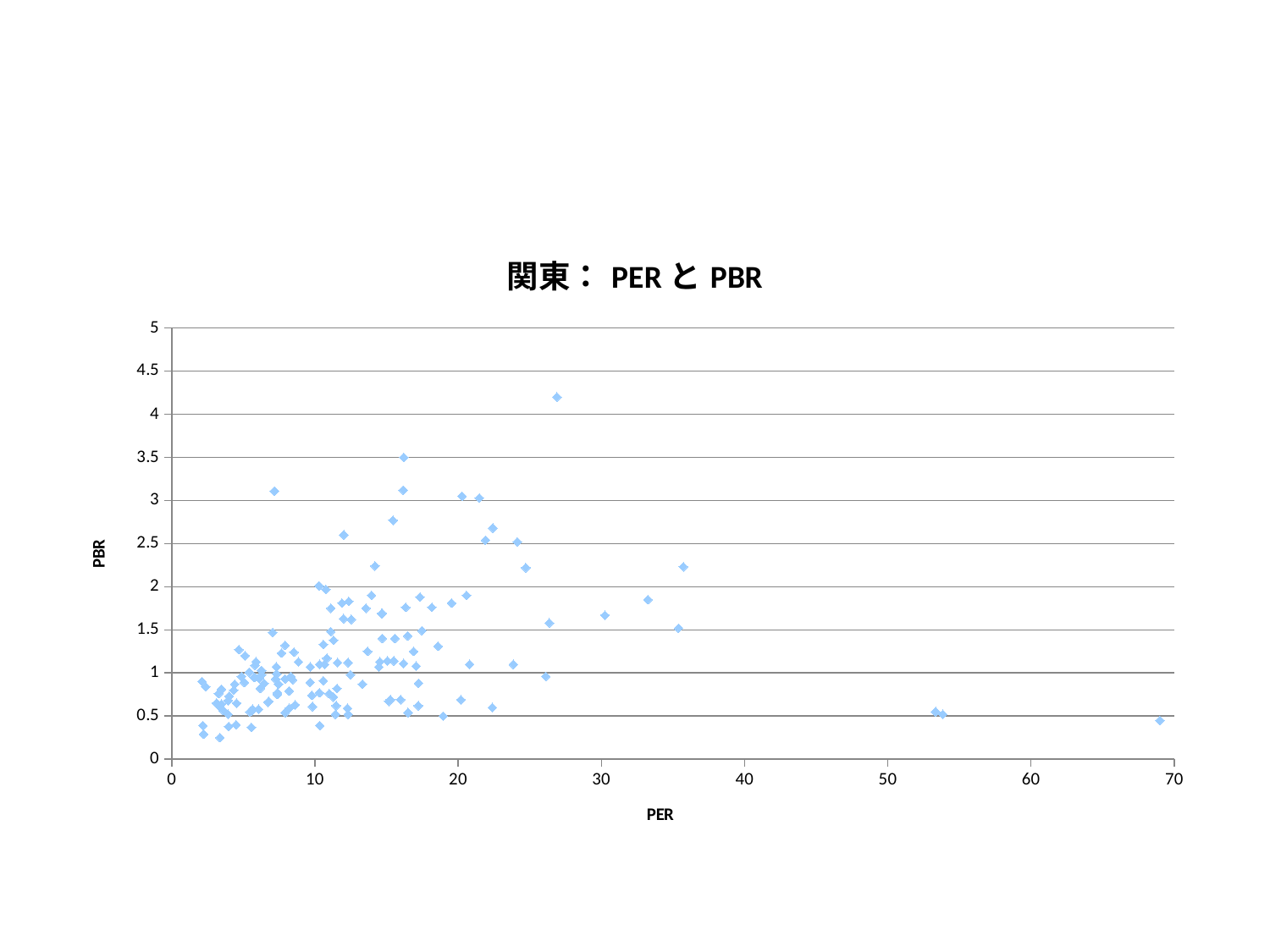
Is the largest PER value plotted on the chart greater or less than 60? greater Is the PER of the point with the highest PBR greater or less than 30? less Is the largest PER value plotted on the chart greater or less than 70? less What are the labels of the x axis and the y axis of the chart? PER (x axis) and PBR (y axis) What kind of chart is shown on the slide? Scatter chart What is the title of the chart? 関東： PER と PBR